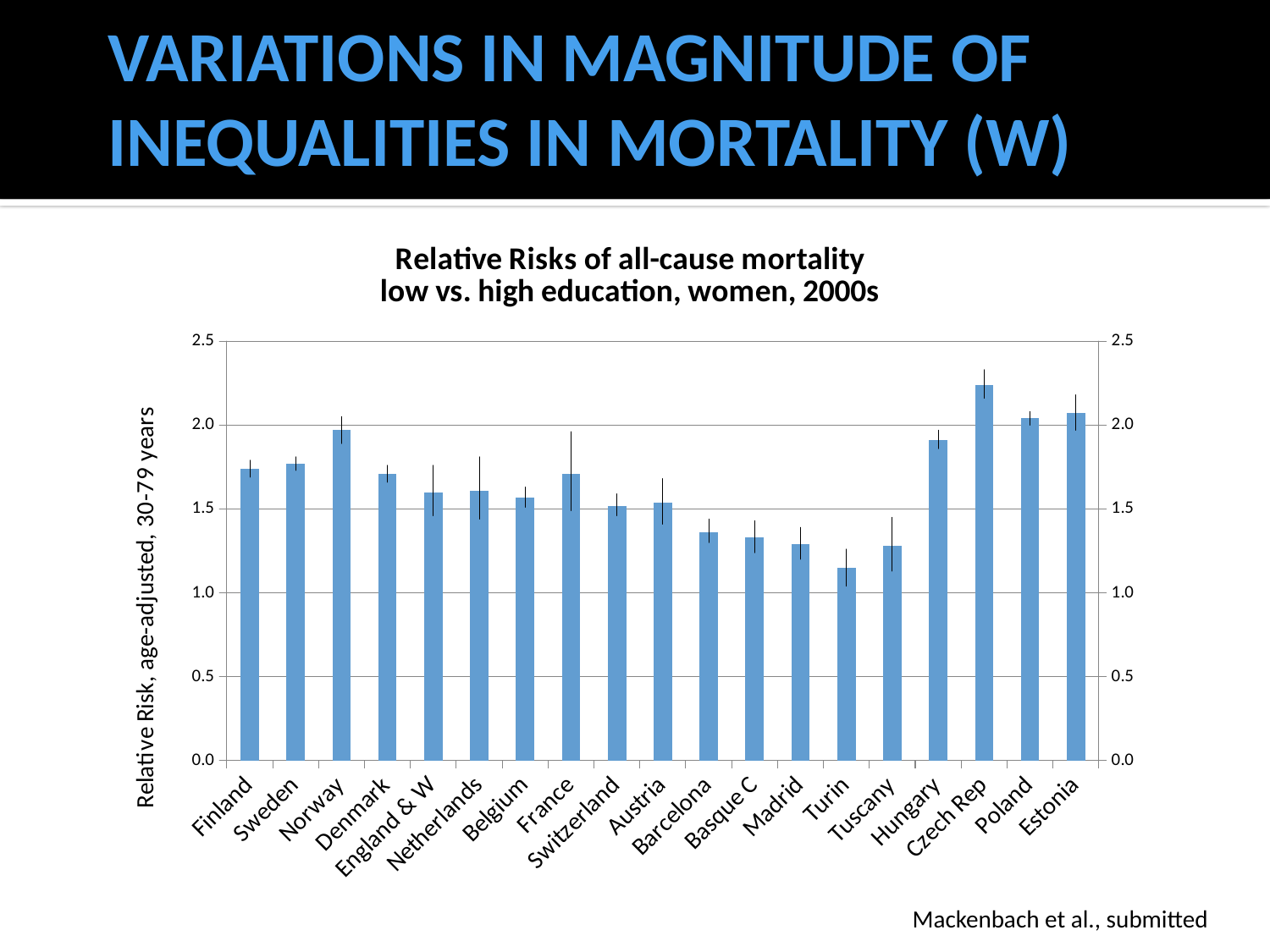
Which country or region has the highest relative risk in the chart? Czech Rep Which has the larger relative risk, Hungary or Austria? Hungary Is the value for Finland greater or less than 1.5? greater Is the value for Madrid greater or less than 1.5? less Is the value for Turin greater or less than 1.5? less What is the label of the vertical axis of the chart? Relative Risk, age-adjusted, 30-79 years Which country or region has the lowest relative risk in the chart? Turin Which has the larger relative risk, Norway or Finland? Norway What kind of chart is shown on the slide? bar chart How many countries or regions are shown on the x axis of the chart? 19